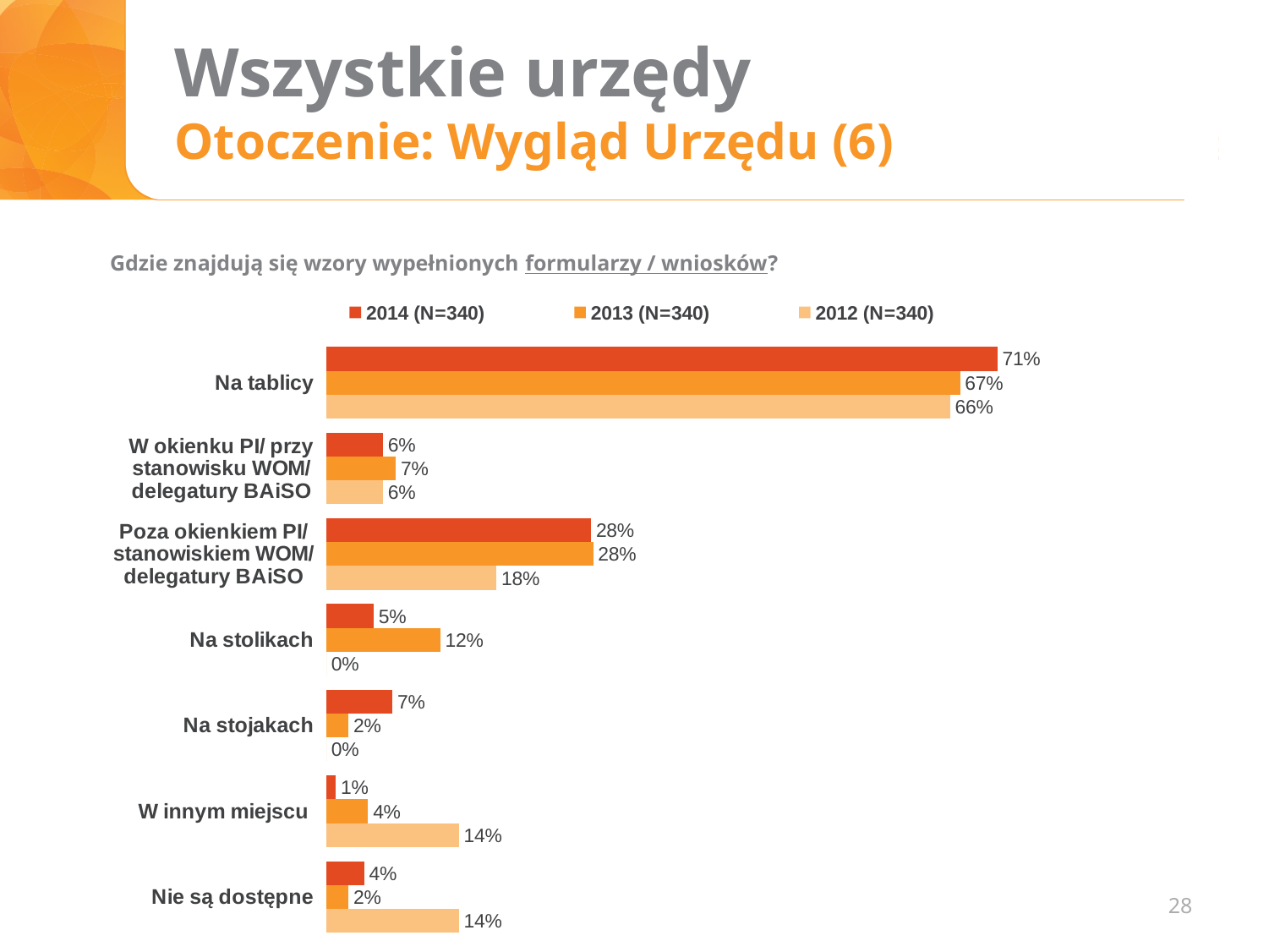
Which category has the highest value in the 2014 (N=340) series? Na tablicy Which is larger for 'Poza okienkiem PI/ stanowiskiem WOM/ delegatury BAiSO': the 2013 value or the 2012 value? 2013 What is the value for 'W innym miejscu' in the 2012 (N=340) series? 14% How many categories are shown on the chart? 7 Which category has the lowest value in the 2014 (N=340) series? W innym miejscu What is the value for 'Na stolikach' in the 2013 (N=340) series? 12% What kind of chart is shown on the slide? Bar chart What is the value for 'Na tablicy' in the 2014 (N=340) series? 71% How many series does the legend list? 3 What sample size (N) is given for each series in the legend? N=340 What is the difference between the 2014 and 2012 values for 'Na tablicy'? 5 percentage points What is the value for 'Nie są dostępne' in the 2013 (N=340) series? 2%